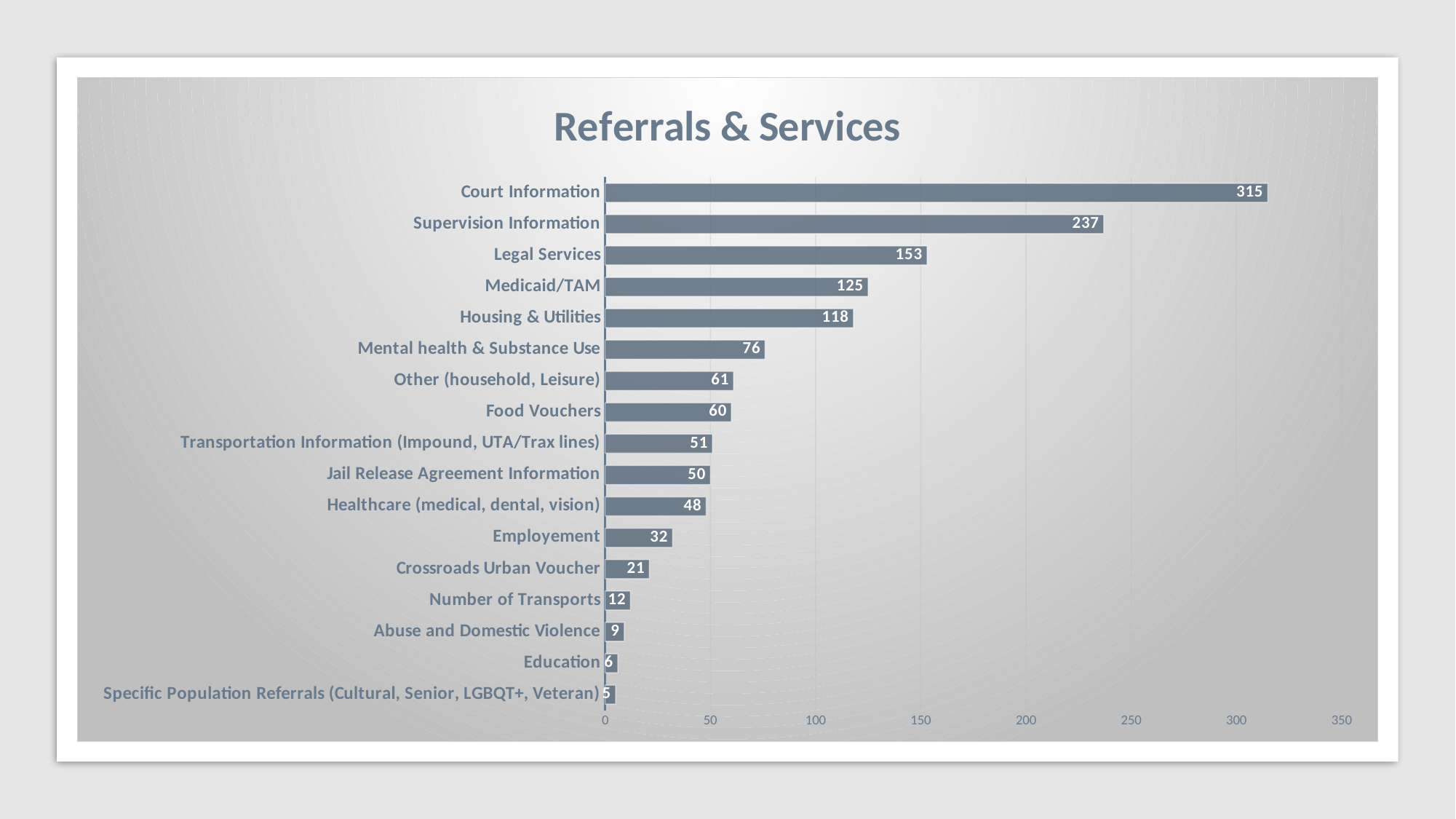
Is the value for Supervision Information greater or less than 200? greater What is the value for Court Information? 315 What kind of chart is this? Bar chart What is the value for Housing & Utilities? 118 Which is larger, Mental health & Substance Use or Employment? Mental health & Substance Use What is the title of the chart? Referrals & Services Which category has the highest value? Court Information What is the difference between Court Information and Supervision Information? 78 What is the difference between Legal Services and Medicaid/TAM? 28 What is the value for Crossroads Urban Voucher? 21 How many categories are shown in the chart? 17 Which category has the lowest value? Specific Population Referrals (Cultural, Senior, LGBQT+, Veteran)